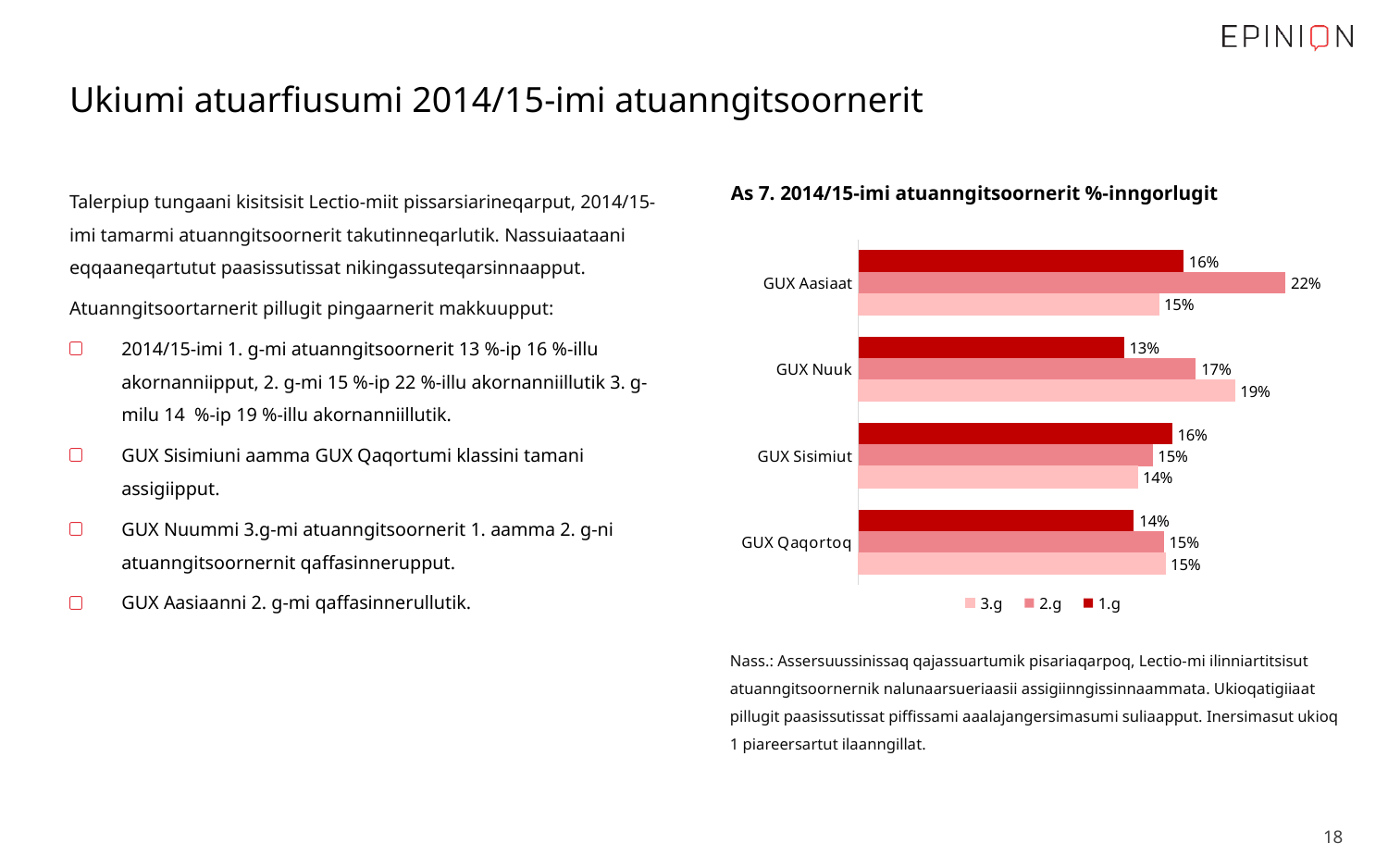
Which school has the lowest 1.g value? GUX Nuuk What is the 1.g value for GUX Nuuk? 13% What is the 3.g value for GUX Nuuk? 19% What is the 2.g value for GUX Aasiaat? 22% Which is larger for GUX Nuuk, the 1.g value or the 3.g value? 3.g What is the title of the chart? As 7. 2014/15-imi atuanngitsoornerit %-inngorlugit What is the 3.g value for GUX Sisimiut? 14% How many series does the legend list? 3 How many schools are shown on the chart? 4 What type of chart is shown on the slide? bar chart What is the difference between the 2.g value and the 3.g value for GUX Aasiaat? 7% Which school has the highest 2.g value? GUX Aasiaat